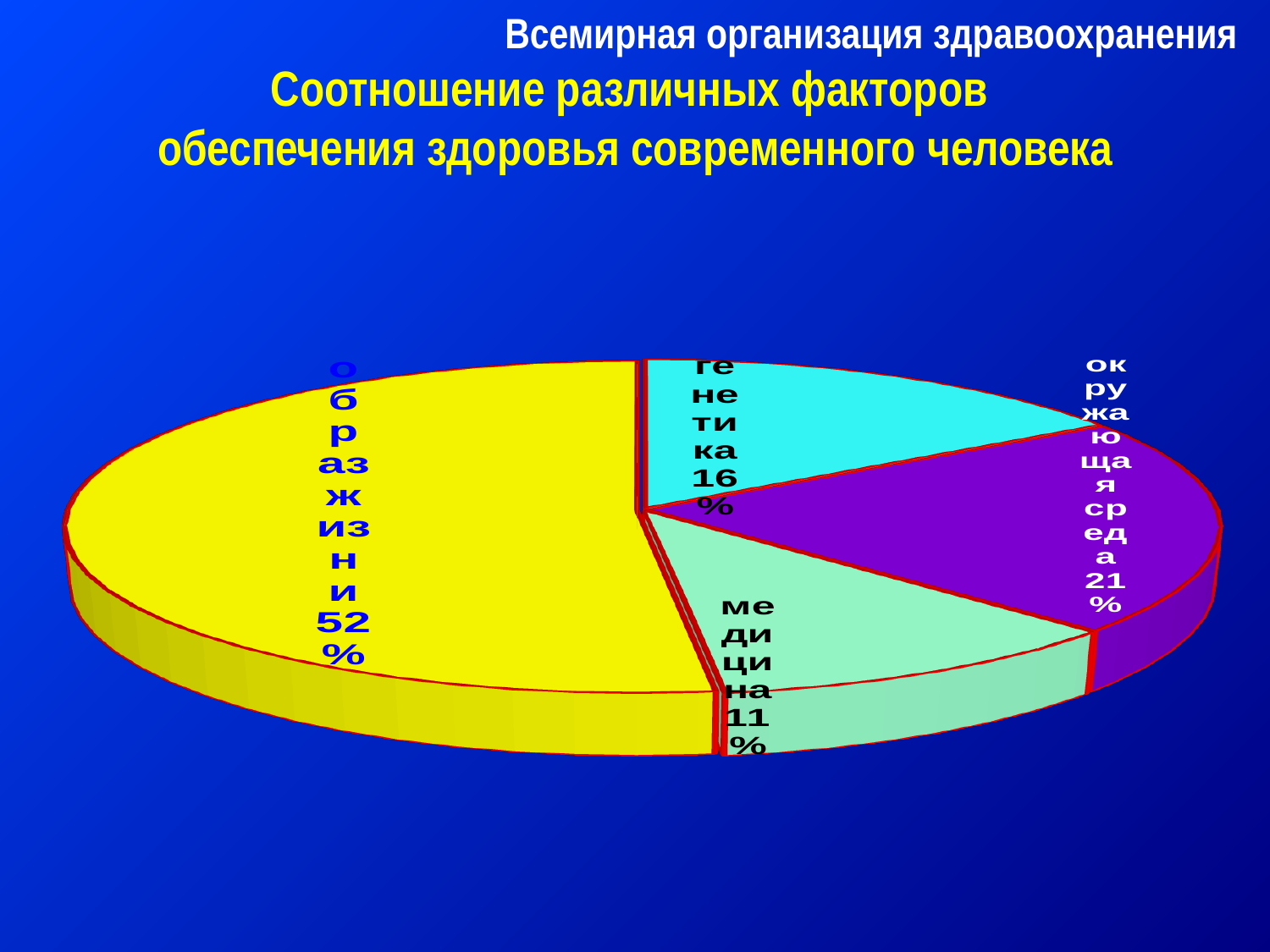
What kind of chart is shown on the slide? pie chart What percentage is shown for медицина? 11% Which factor has the smallest share of the pie? медицина Which is larger, the share of генетика or the share of медицина? генетика What is the difference between the shares of окружающая среда and генетика? 5% What colour is the slice for образ жизни? yellow What is the difference between the shares of образ жизни and окружающая среда? 31% What percentage is shown for окружающая среда? 21% Which factor has the largest share of the pie? образ жизни How many slices does the pie chart have? 4 What percentage is shown for образ жизни? 52% What percentage is shown for генетика? 16%